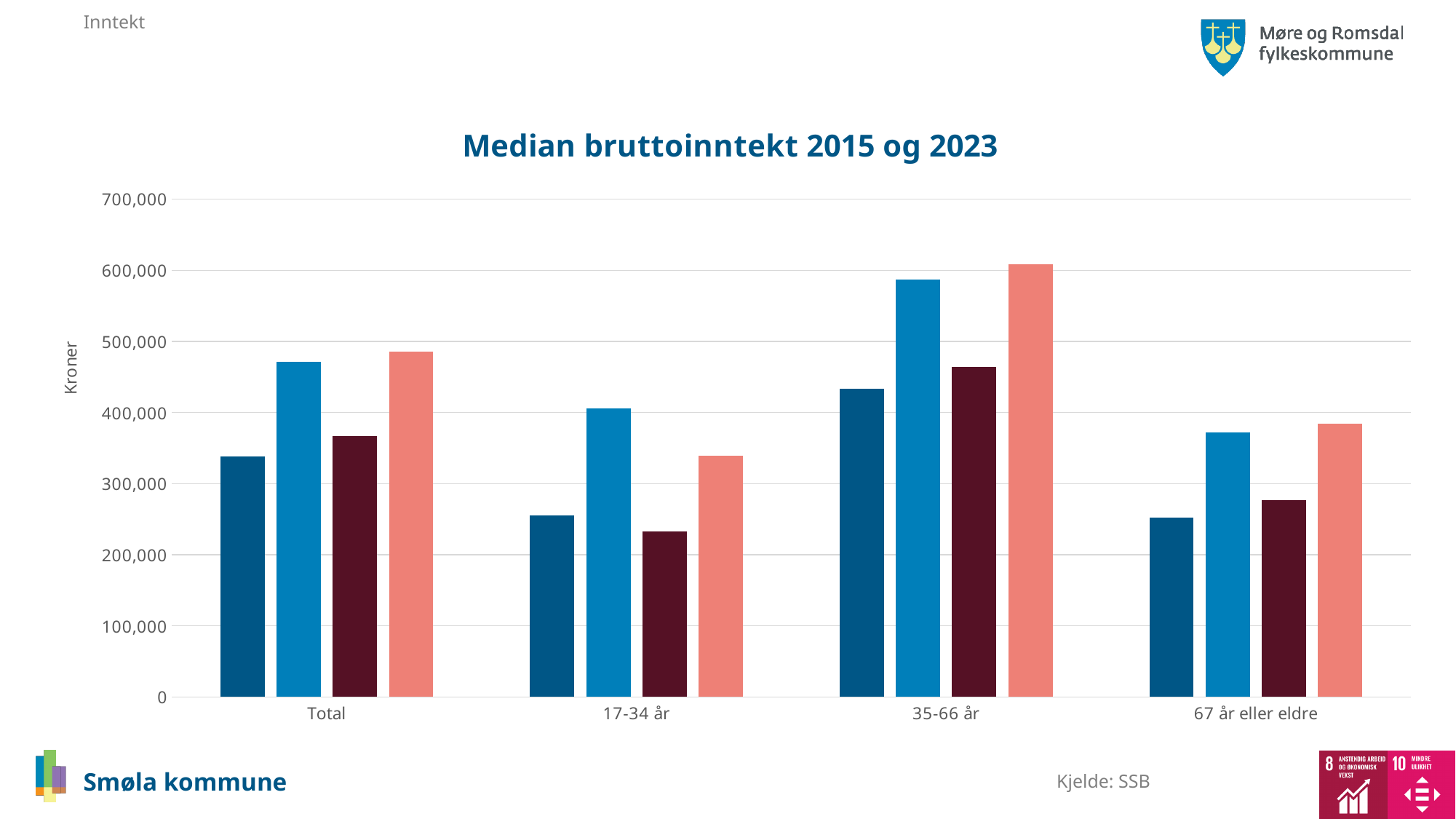
Which category has the lowest dark red bar? 17-34 år Is the dark blue bar for 17-34 år greater or less than 300,000? less How many age categories are shown along the x axis? 4 What kind of chart is shown on the slide? bar chart Is the salmon-coloured bar for 35-66 år greater or less than 500,000? greater Which category contains the tallest bar in the chart? 35-66 år What is the label on the vertical axis of the chart? Kroner Is the dark red bar for 67 år eller eldre greater or less than 300,000? less Which is larger: the dark blue bar for Total or the dark blue bar for 35-66 år? 35-66 år How many bars are plotted for each category? 4 What is the title of the chart? Median bruttoinntekt 2015 og 2023